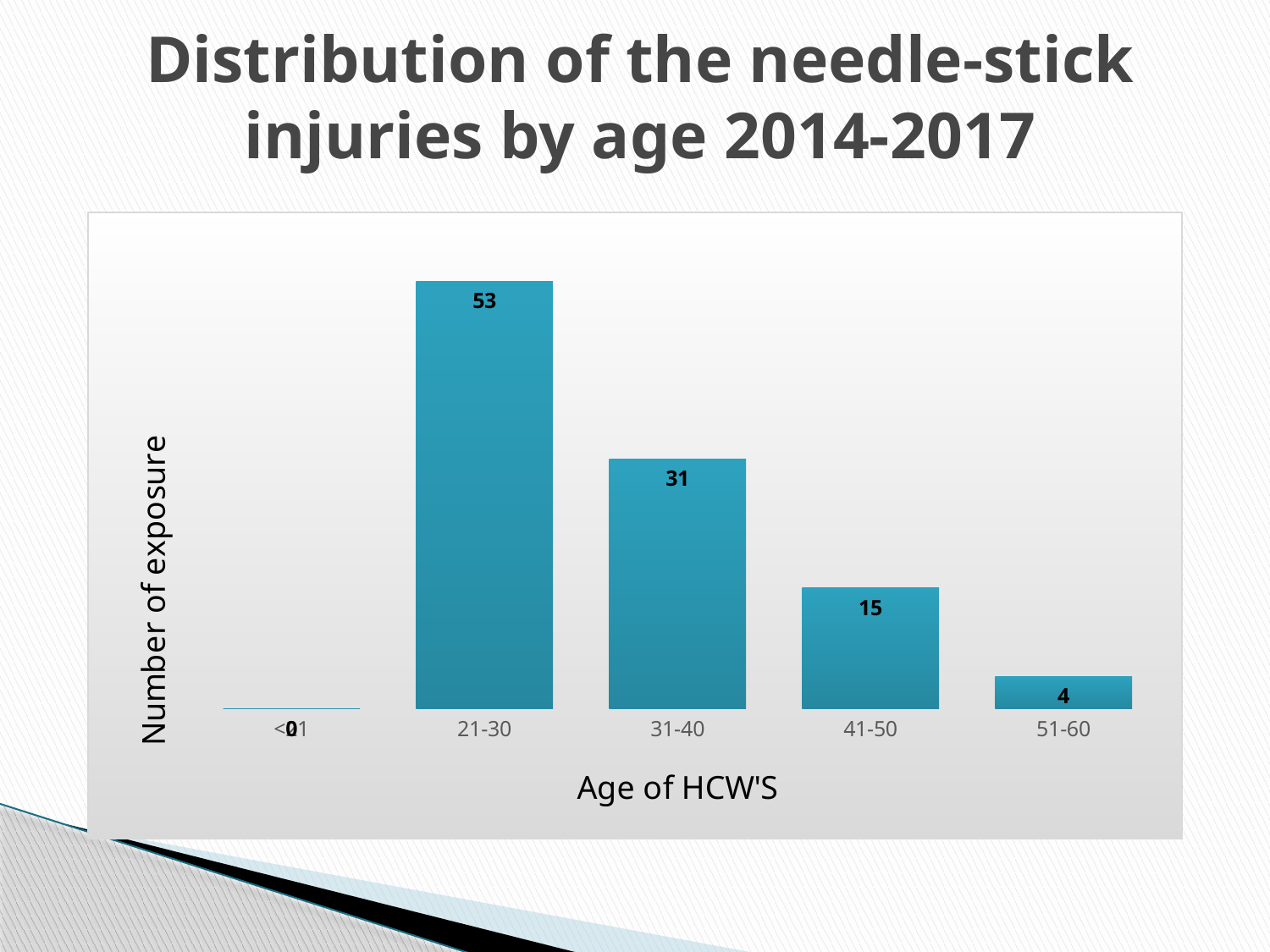
Which age group has the highest number of exposures? 21-30 What is the difference in exposures between the 21-30 and 31-40 age groups? 22 What is the number of exposures for the 41-50 age group? 15 Which age group with a visible bar has the lowest number of exposures? 51-60 What is the number of exposures for the 51-60 age group? 4 What kind of chart is shown on the slide? Bar chart What is the number of exposures for the 21-30 age group? 53 Which age group has more exposures, 31-40 or 41-50? 31-40 How many age groups are shown on the x axis? 5 What is the difference in exposures between the 41-50 and 51-60 age groups? 11 What is the label of the x axis? Age of HCW'S What is the number of exposures for the 31-40 age group? 31